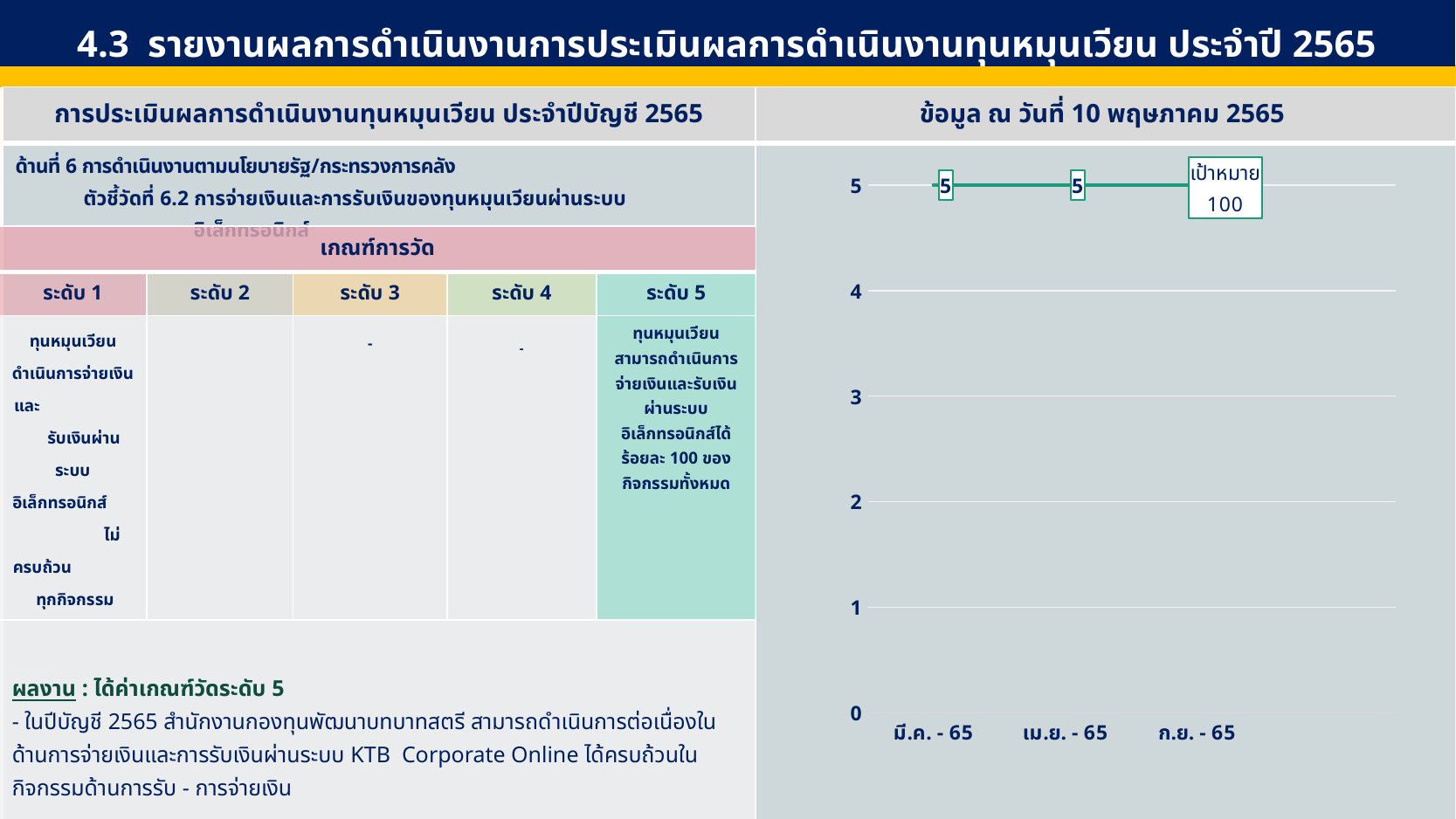
What is the value plotted for เม.ย. - 65? 5 Is the value for เม.ย. - 65 greater or less than 3? greater Does the line rise, fall or stay flat from มี.ค. - 65 to เม.ย. - 65? stays flat Is the value for มี.ค. - 65 greater or less than 4? greater How many categories are shown on the x axis of the chart? 3 What is the highest tick value shown on the y axis of the chart? 5 What is the difference between the values for มี.ค. - 65 and เม.ย. - 65? 0 What kind of chart is shown on the right side of the slide? line chart What is the value plotted for มี.ค. - 65? 5 What label is shown at the ก.ย. - 65 point on the chart? เป้าหมาย 100